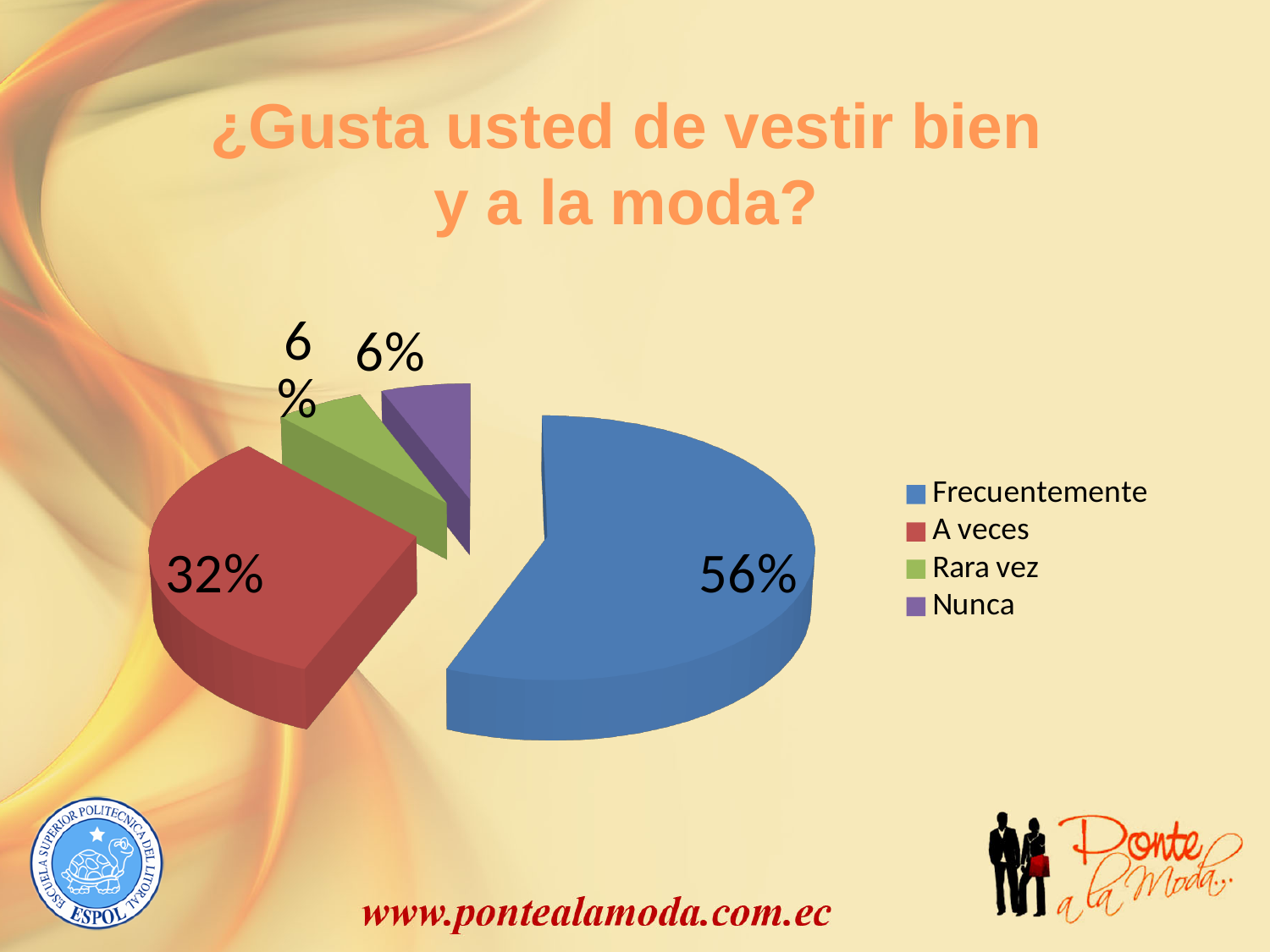
Which response category has the largest share of the pie? Frecuentemente What percentage of respondents answered "Nunca"? 6% What percentage of respondents answered "Rara vez"? 6% What percentage of respondents answered "Frecuentemente"? 56% What is the difference in percentage points between "A veces" and "Nunca"? 26 Which is larger, the share for "A veces" or the share for "Rara vez"? A veces What percentage of respondents answered "A veces"? 32% What is the difference in percentage points between "Frecuentemente" and "A veces"? 24 What type of chart is shown on the slide? Pie chart How many response categories are shown in the pie chart? 4 Is the share for "Frecuentemente" greater or less than 50%? greater Which colour represents "A veces" in the legend? Red